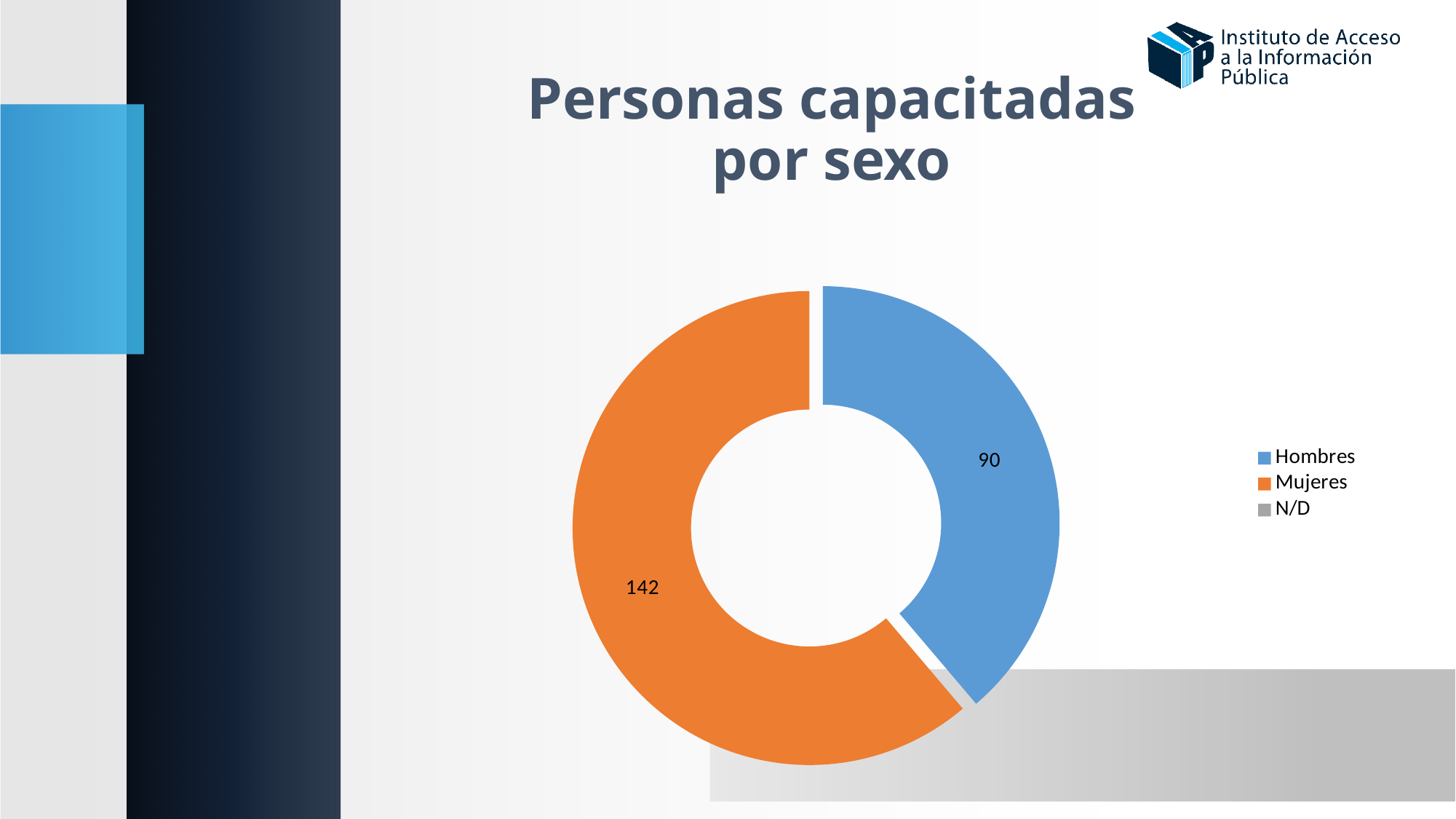
What kind of chart is shown on the slide? Doughnut (pie) chart How many entries does the chart legend list? 3 Which is larger, the value for Hombres or the value for Mujeres? Mujeres What is the value for Mujeres in the chart? 142 What is the difference between the values for Mujeres and Hombres? 52 What is the value for Hombres in the chart? 90 What colour represents Mujeres in the chart? Orange What is the title of the chart on the slide? Personas capacitadas por sexo Which category has the largest slice in the chart? Mujeres Is the value for Mujeres greater or less than 100? greater